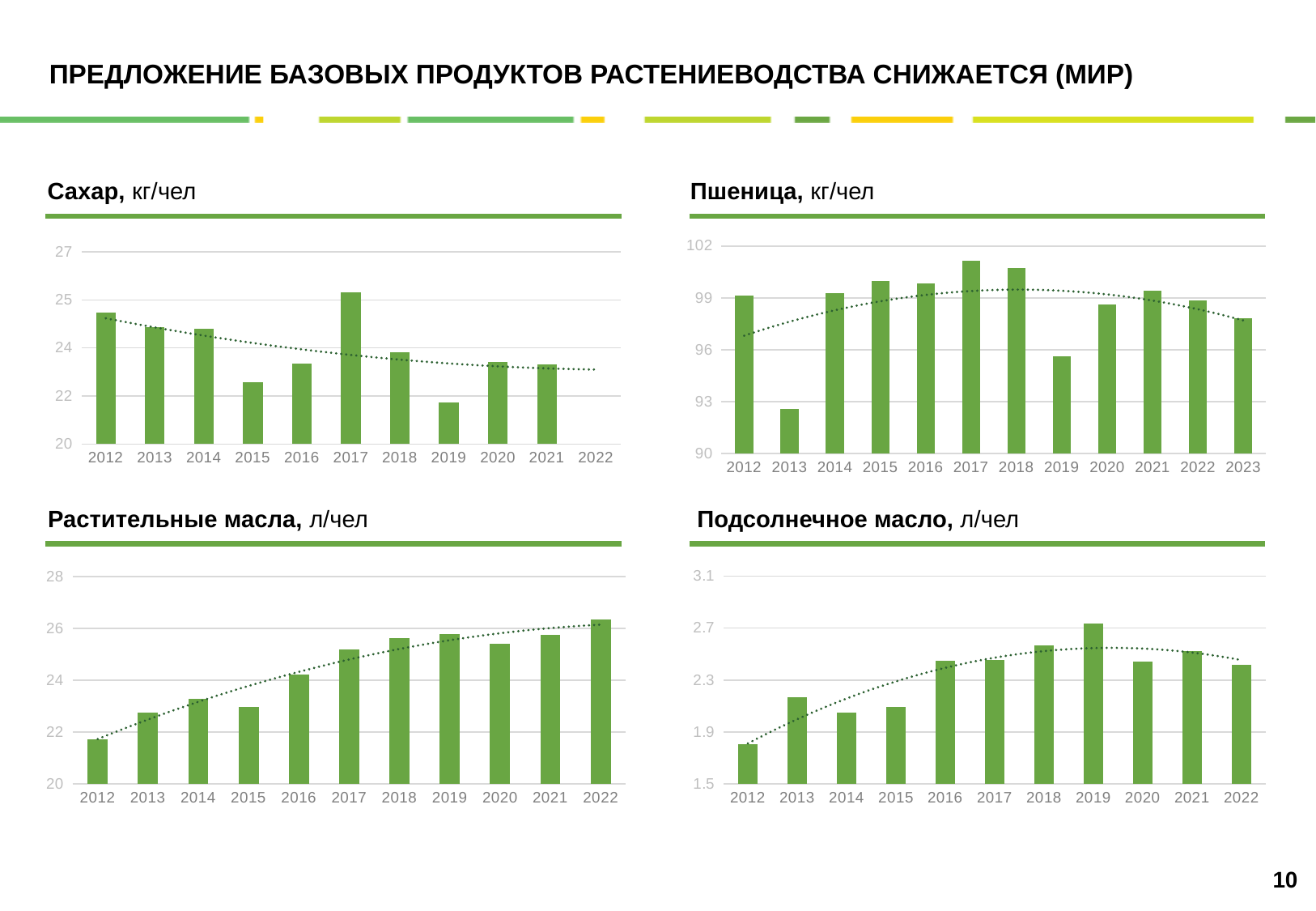
What type of chart is the 'Подсолнечное масло, л/чел' chart? bar chart In the 'Растительные масла, л/чел' chart, do the values generally rise or fall from 2012 to 2022? rise In the 'Сахар, кг/чел' chart, is the value for 2019 greater or less than 22? less In the 'Сахар, кг/чел' chart, which year has the highest bar? 2017 In the 'Растительные масла, л/чел' chart, which year has the highest value? 2022 In the 'Подсолнечное масло, л/чел' chart, which year has the highest value? 2019 In the 'Сахар, кг/чел' chart, which year has the lowest bar? 2019 In the 'Пшеница, кг/чел' chart, is the value for 2013 greater or less than 93? less In the 'Пшеница, кг/чел' chart, how many years are plotted? 12 In the 'Подсолнечное масло, л/чел' chart, is the value for 2012 greater or less than 1.9? less In the 'Пшеница, кг/чел' chart, which year has the lowest value? 2013